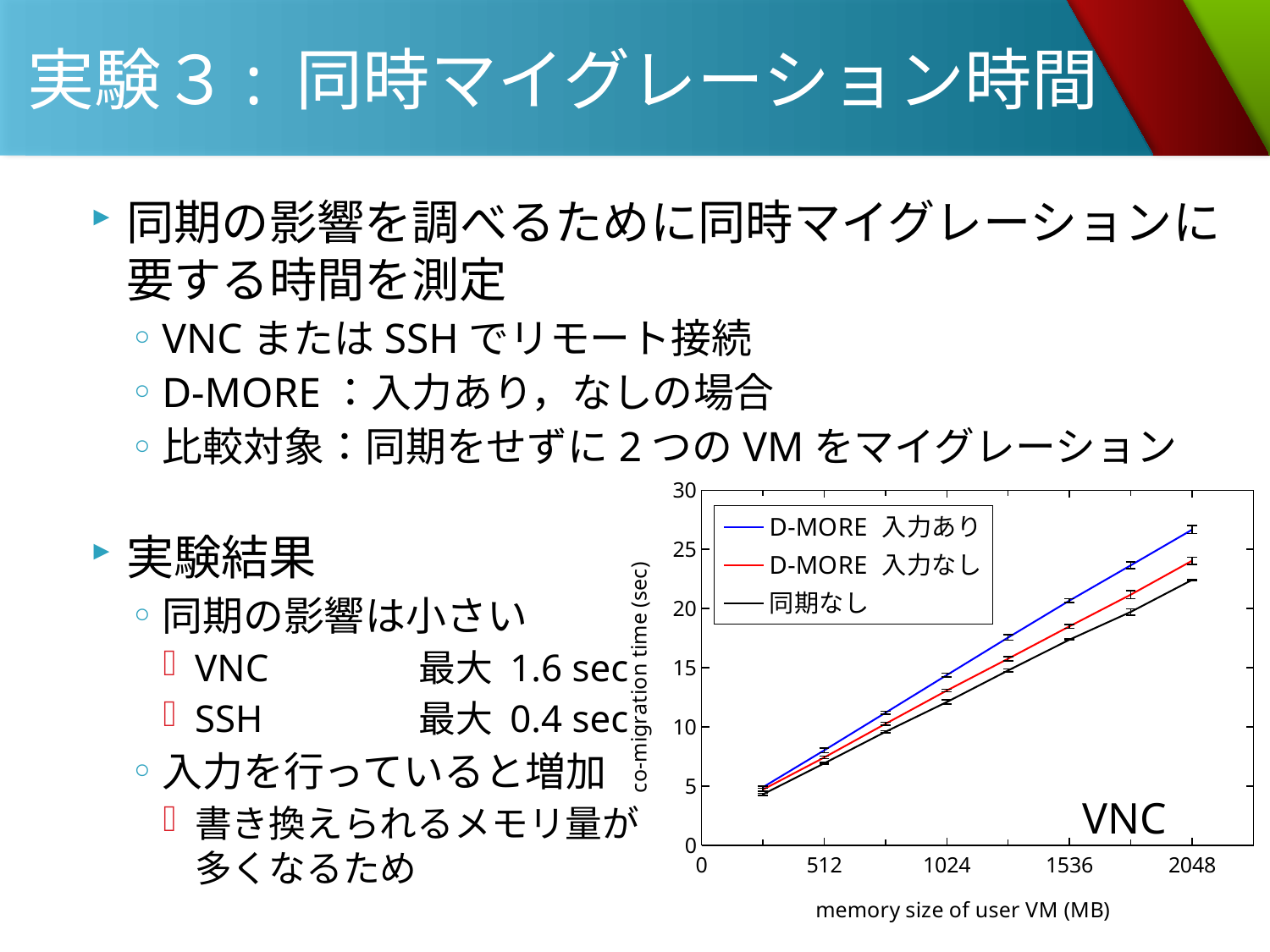
Which series are listed in the chart legend? D-MORE 入力あり, D-MORE 入力なし, 同期なし What kind of chart is shown on the slide? line chart Is the co-migration time for D-MORE 入力なし at 1024 MB greater or less than 15? less At 2048 MB, which series has the larger co-migration time, D-MORE 入力あり or 同期なし? D-MORE 入力あり Is the co-migration time for 同期なし at 512 MB greater or less than 10? less Is the co-migration time for 同期なし at 2048 MB greater or less than 25? less What is the label of the x axis of the chart? memory size of user VM (MB) Which series has the highest co-migration time at a memory size of 2048 MB? D-MORE 入力あり Which series has the lowest co-migration time at a memory size of 2048 MB? 同期なし How many series does the chart legend list? 3 Does the co-migration time rise or fall as the memory size of the user VM increases? rise